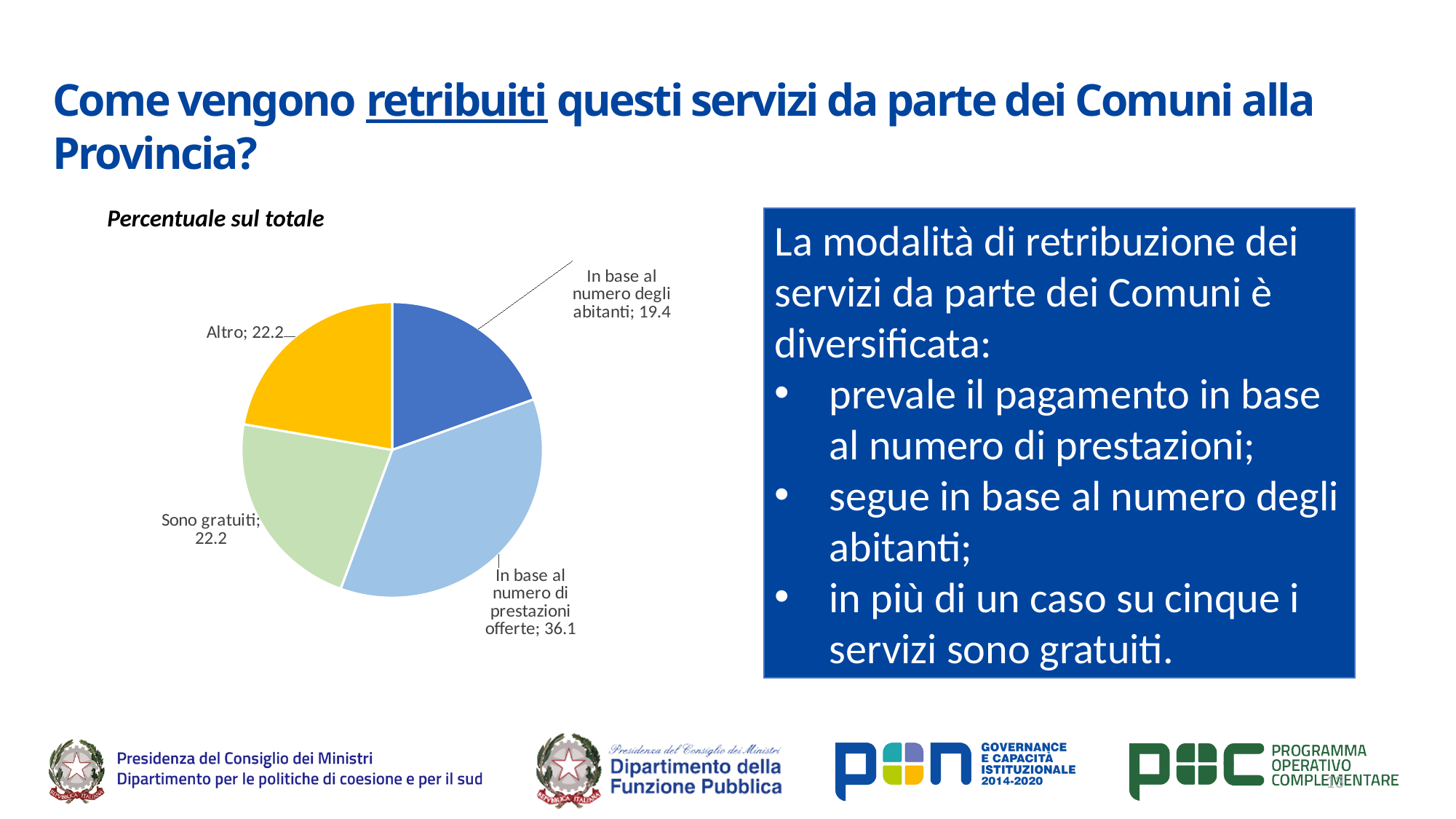
What is the value for "Sono gratuiti"? 22.2 What is the value for "In base al numero degli abitanti"? 19.4 What is the value for "Altro"? 22.2 Which category has the largest slice of the pie? In base al numero di prestazioni offerte Which category has the smallest slice of the pie? In base al numero degli abitanti What is the difference between the values for "In base al numero di prestazioni offerte" and "In base al numero degli abitanti"? 16.7 Which is larger, the value for "Sono gratuiti" or the value for "In base al numero degli abitanti"? Sono gratuiti How many slices does the pie chart have? 4 What is the value for "In base al numero di prestazioni offerte"? 36.1 What kind of chart is shown on the slide? Pie chart What is the title of the chart? Percentuale sul totale What colour is the slice for "Altro"? Yellow